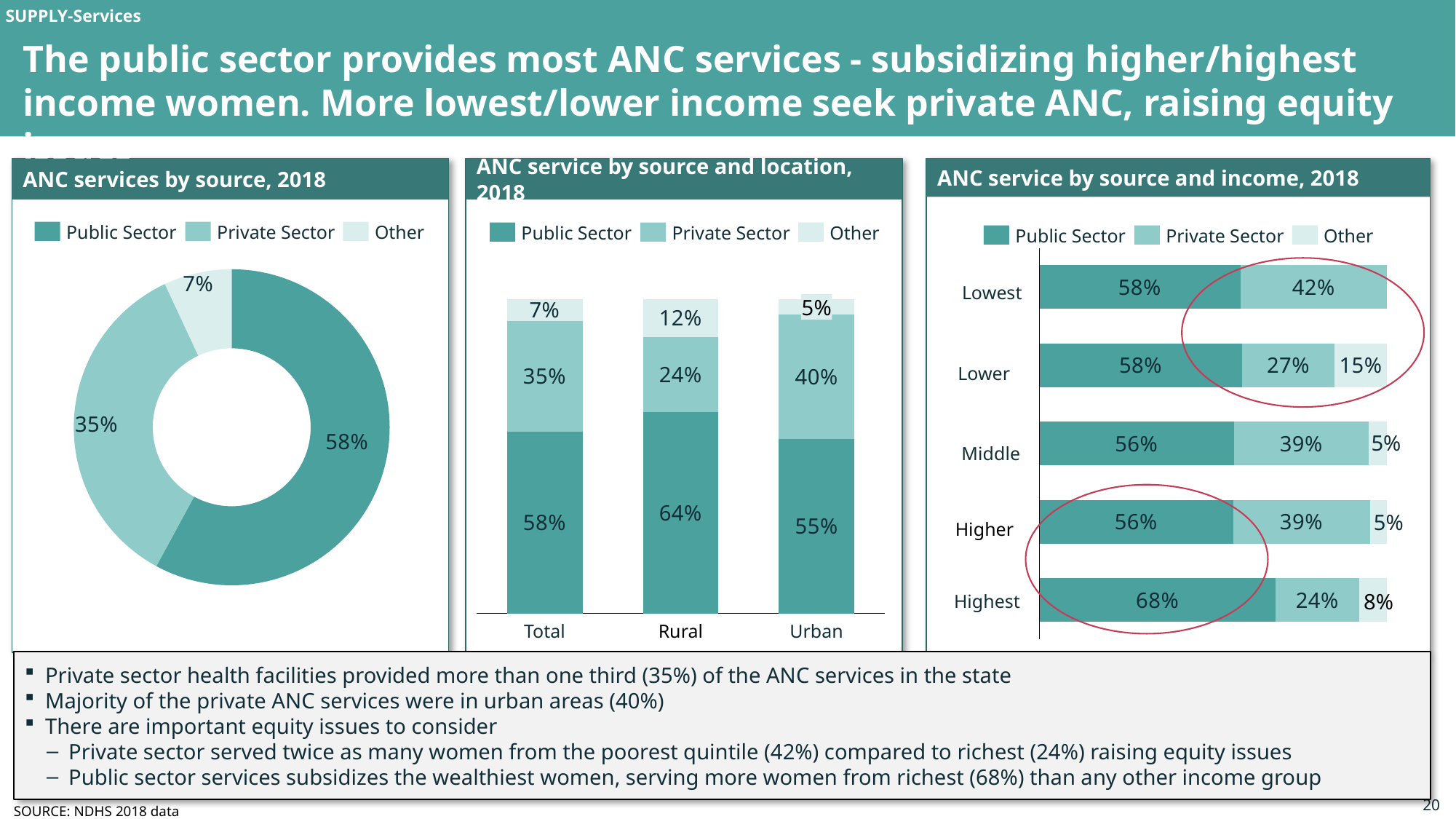
In the 'ANC services by source, 2018' chart, what share of ANC services is provided by the Public Sector? 58% How many categories are shown on the x axis of the 'ANC service by source and location, 2018' chart? 3 In the 'ANC service by source and location, 2018' chart, what is the Private Sector value for Urban? 40% In the 'ANC services by source, 2018' chart, what share is labelled for Other? 7% In the 'ANC service by source and location, 2018' chart, what is the difference between the Private Sector values for Urban and Rural? 16% In the 'ANC service by source and income, 2018' chart, what is the Private Sector value for the Lowest income group? 42% In the 'ANC service by source and location, 2018' chart, what is the Public Sector value for Rural? 64% In the 'ANC service by source and location, 2018' chart, which location has the highest Public Sector share? Rural In the 'ANC service by source and income, 2018' chart, is the Private Sector value larger for Lowest or for Highest? Lowest In the 'ANC service by source and income, 2018' chart, which income group has the highest Public Sector share? Highest What kind of chart is 'ANC services by source, 2018'? Doughnut (pie) chart How many series does the legend of the 'ANC service by source and income, 2018' chart list? 3